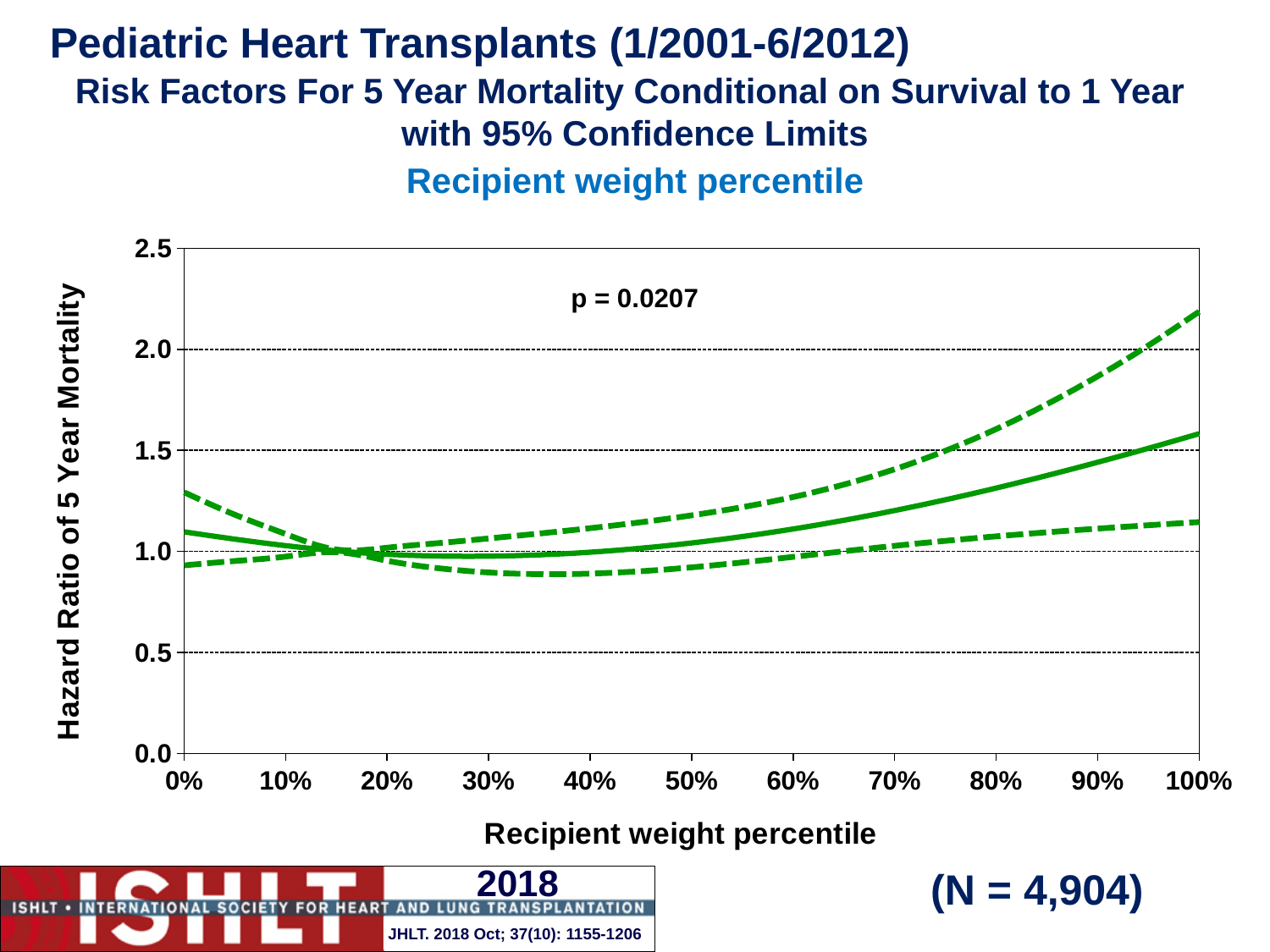
Is the value of the solid line at a recipient weight percentile of 0% greater or less than 1.0? greater What is the sample size (N) shown on the slide? N = 4,904 What is the p-value printed on the chart? p = 0.0207 Is the value of the lower dashed confidence limit at a recipient weight percentile of 40% greater or less than 1.0? less Is the solid line's value at 100% larger or smaller than its value at 0%? larger Is the value of the solid line at a recipient weight percentile of 100% greater or less than 1.5? greater How many lines are plotted on the chart? 3 How many tick labels are shown on the x axis (Recipient weight percentile)? 11 Between recipient weight percentiles of 50% and 100%, does the solid hazard ratio line rise or fall? rise What kind of chart is shown on the slide? line chart At which recipient weight percentile does the solid hazard ratio line reach its highest value? 100%